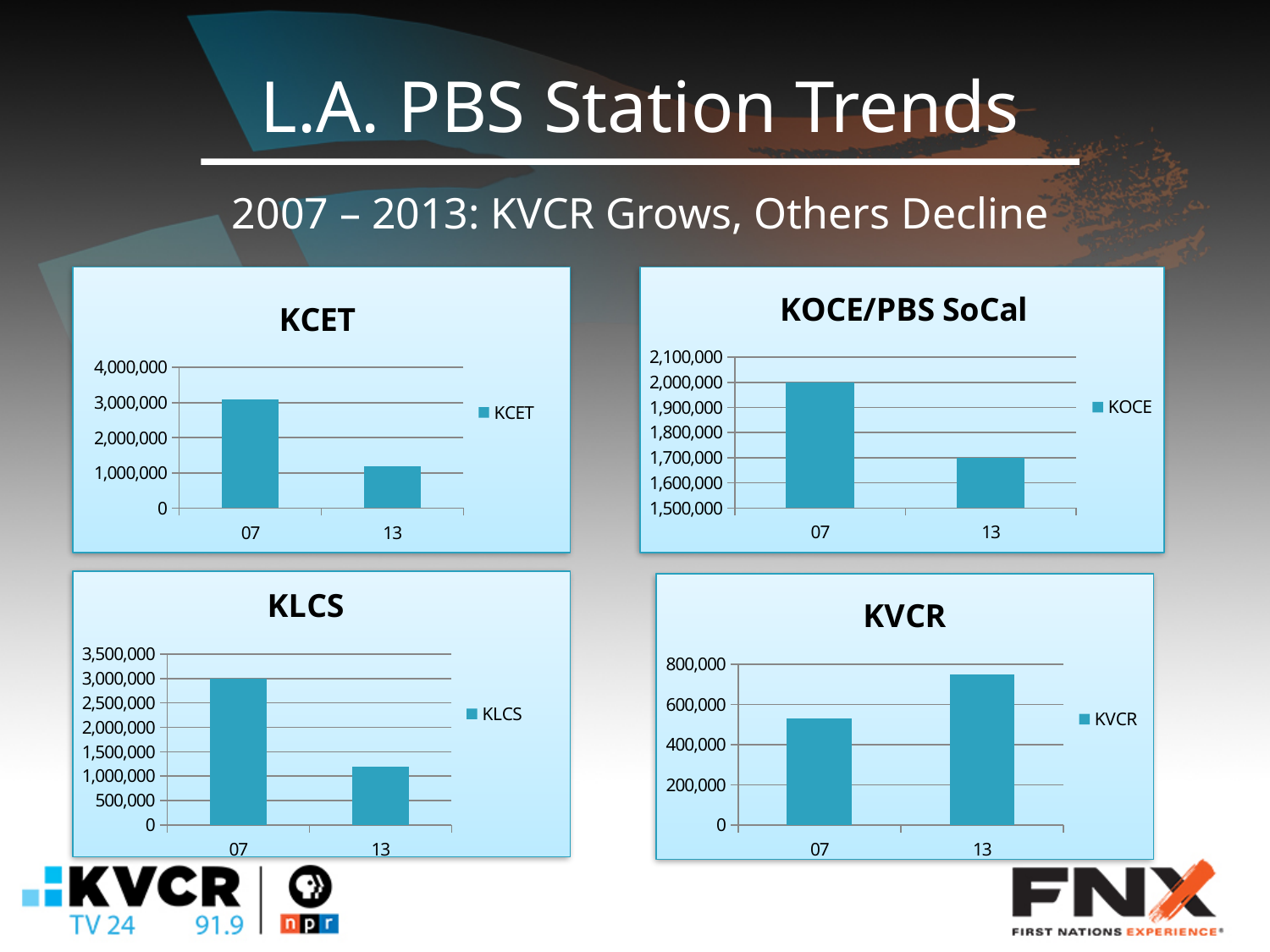
In the KCET chart, is the value for 13 greater or less than 2,000,000? less In the KLCS chart, is the value for 13 greater or less than 1,500,000? less What type of chart is the KVCR chart? bar chart How many charts are shown on the slide? 4 In the KCET chart, which year has the higher bar, 07 or 13? 07 In the KVCR chart, is the value for 13 greater or less than 600,000? greater In the KOCE/PBS SoCal chart, what is the value for 07? 2,000,000 In the KOCE/PBS SoCal chart, what is the difference between the 07 and 13 values? 300,000 In the KLCS chart, what is the value for 07? 3,000,000 In the KOCE/PBS SoCal chart, what is the value for 13? 1,700,000 In the KVCR chart, do the values rise or fall from 07 to 13? rise